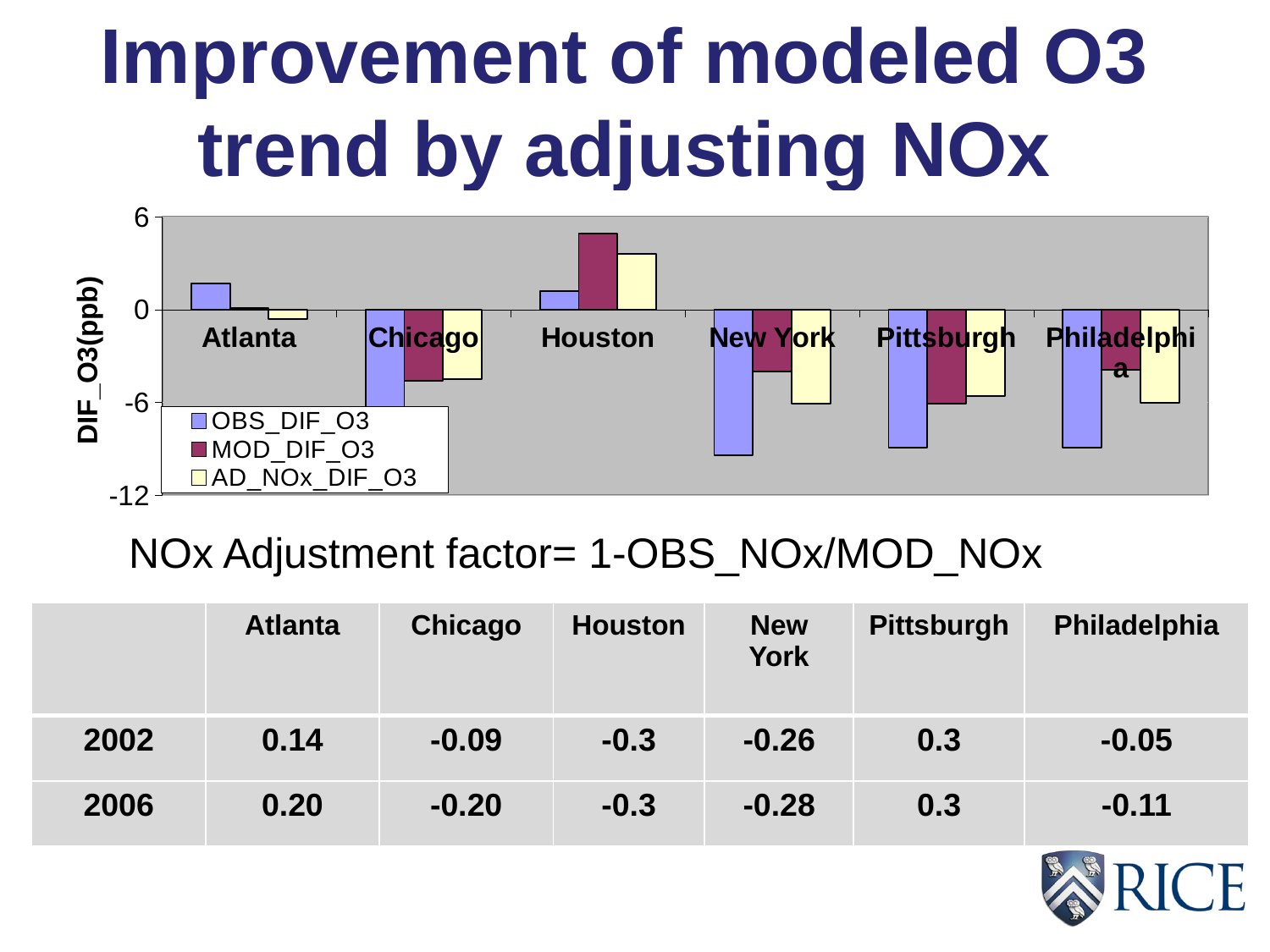
Is the OBS_DIF_O3 value for New York greater or less than -6? less Which is larger: the OBS_DIF_O3 value for Atlanta or the OBS_DIF_O3 value for Chicago? Atlanta What kind of chart is shown on the slide? bar chart How many series does the chart legend list? 3 Which series is shown in yellow in the chart legend? AD_NOx_DIF_O3 Is the OBS_DIF_O3 value for Pittsburgh greater or less than -6? less Which city has the highest MOD_DIF_O3 value? Houston For Houston, which is larger: the MOD_DIF_O3 value or the AD_NOx_DIF_O3 value? MOD_DIF_O3 Which city has the highest AD_NOx_DIF_O3 value? Houston Is the MOD_DIF_O3 value for Houston greater or less than 0? greater What is the title of the y axis of the chart? DIF_O3(ppb) How many cities are shown on the x axis of the chart? 6